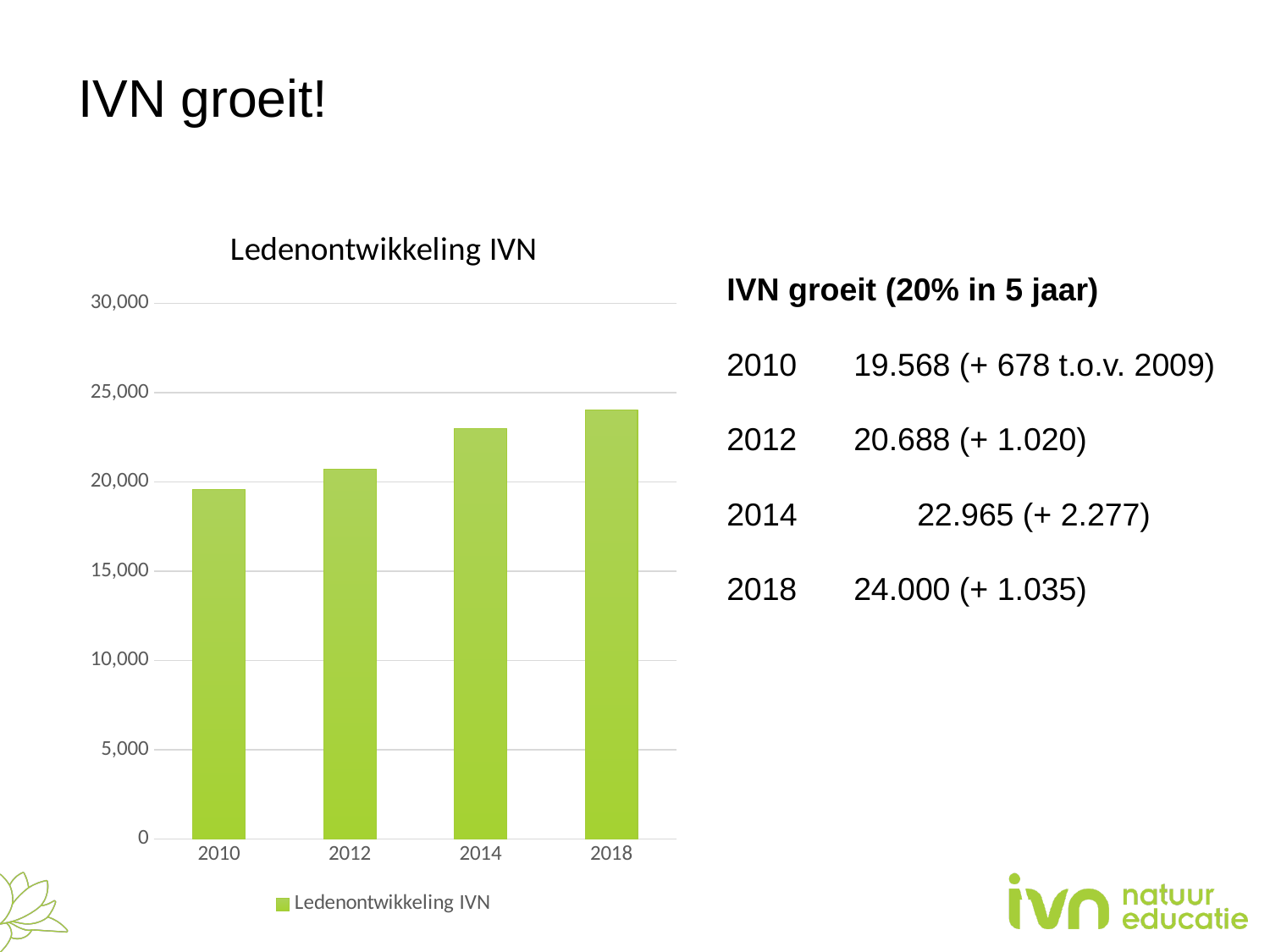
Which is larger, the value for 2014 or the value for 2012? 2014 According to the slide, what is the number of members for 2010? 19.568 According to the slide, what is the number of members for 2018? 24.000 How many series does the chart legend list? 1 Which year has the highest bar in the chart? 2018 What is the title of the chart? Ledenontwikkeling IVN Do the values rise or fall from 2010 to 2018 along the x axis? rise How many bars (years) are shown in the chart? 4 Is the value for 2018 greater or less than 25,000? less Is the value for 2014 greater or less than 20,000? greater What type of chart is shown on the slide? bar chart Which year has the lowest bar in the chart? 2010